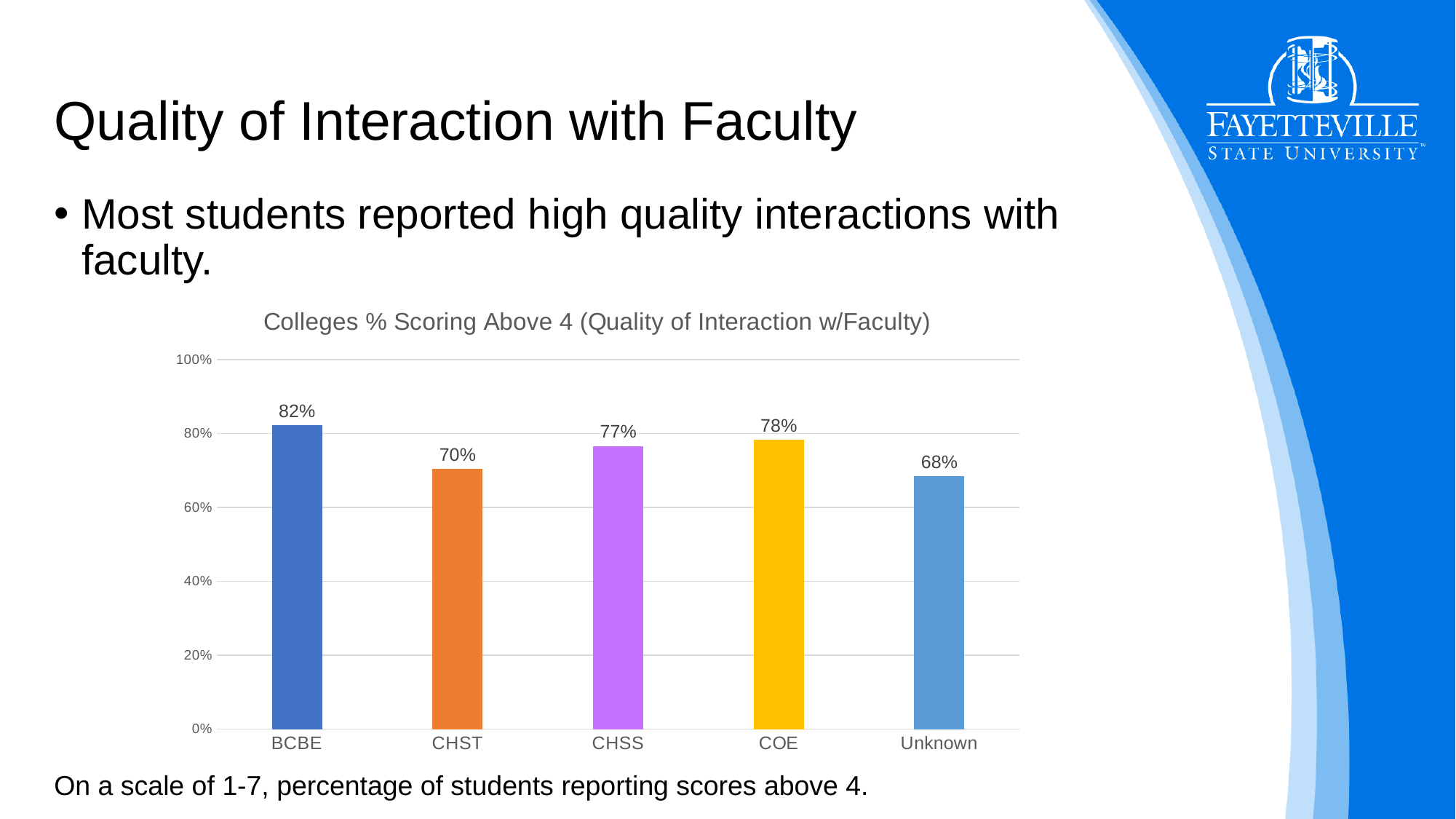
What is the value for BCBE? 82% What is the difference between the values for BCBE and CHST? 12% What colour is the bar for COE? yellow How many categories are shown on the x axis? 5 What is the title of the chart? Colleges % Scoring Above 4 (Quality of Interaction w/Faculty) What is the value for CHST? 70% What kind of chart is shown on the slide? bar chart Which college has the highest percentage scoring above 4? BCBE What is the value for Unknown? 68% Which category has the lowest percentage scoring above 4? Unknown Which is larger, the value for CHST or the value for COE? COE Is the value for CHSS greater or less than 60%? greater